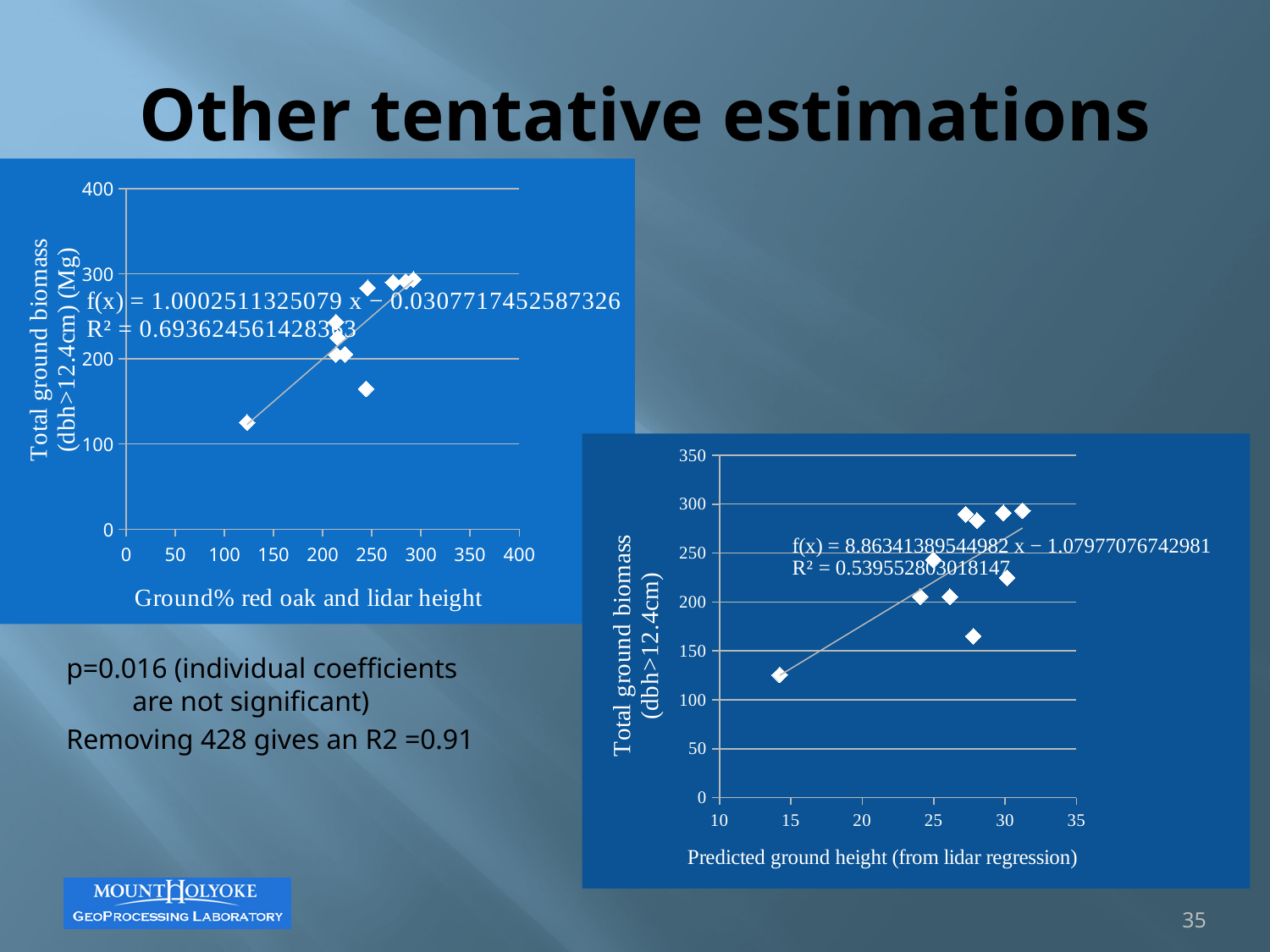
What R² value is shown on the chart on the right? 0.539552803018147 In the chart on the right, do the biomass values generally rise or fall as predicted ground height increases? rise In the chart on the right, is the biomass value of the point with the lowest predicted ground height greater or less than 150? less What is the x-axis title of the chart on the right? Predicted ground height (from lidar regression) In the chart on the left, do the biomass values generally rise or fall along the x axis? rise What trendline equation is shown on the chart on the left? f(x) = 1.0002511325079 x − 0.0307717452587326 What is the x-axis title of the chart on the left? Ground% red oak and lidar height What trendline equation is shown on the chart on the right? f(x) = 8.86341389544982 x − 1.07977076742981 In the chart on the left, is the biomass value of the leftmost point greater or less than 200? less What kind of chart is the chart on the left of the slide? scatter chart What kind of chart is the chart on the right of the slide? scatter chart In the chart on the right, is the biomass value of the point with the lowest predicted ground height greater or less than 100? greater